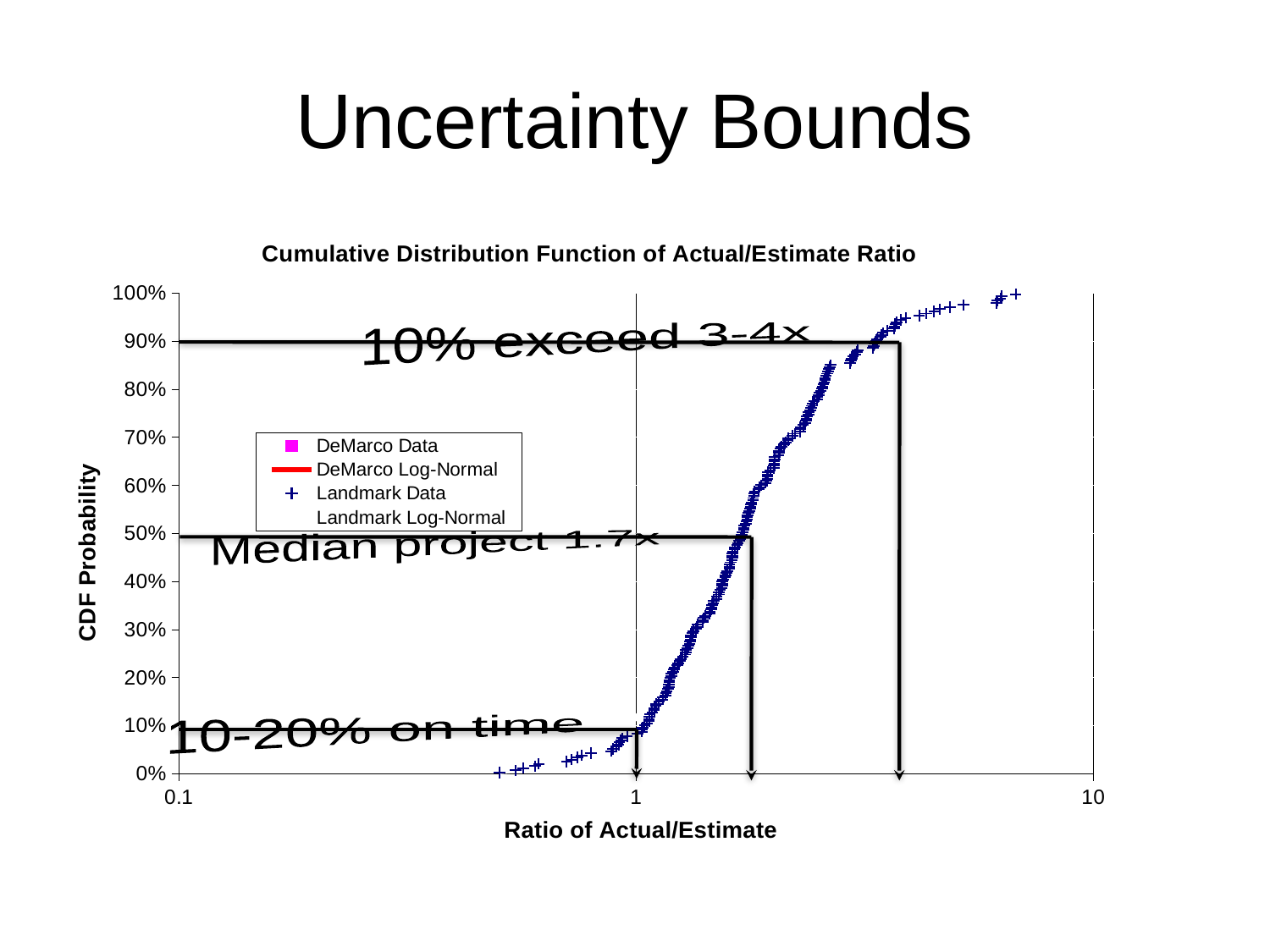
What is the label of the y axis? CDF Probability What kind of chart is shown on the slide? scatter chart What is the title of the chart? Cumulative Distribution Function of Actual/Estimate Ratio Is the CDF probability for Landmark Data at a ratio of 1 greater or less than 50%? less Is the CDF probability for Landmark Data at a ratio of 1 greater or less than 30%? less Is the highest plotted CDF probability for Landmark Data greater or less than 90%? greater How many series does the chart legend list? 4 Do the plotted Landmark Data values rise or fall as the ratio increases along the x axis? rise